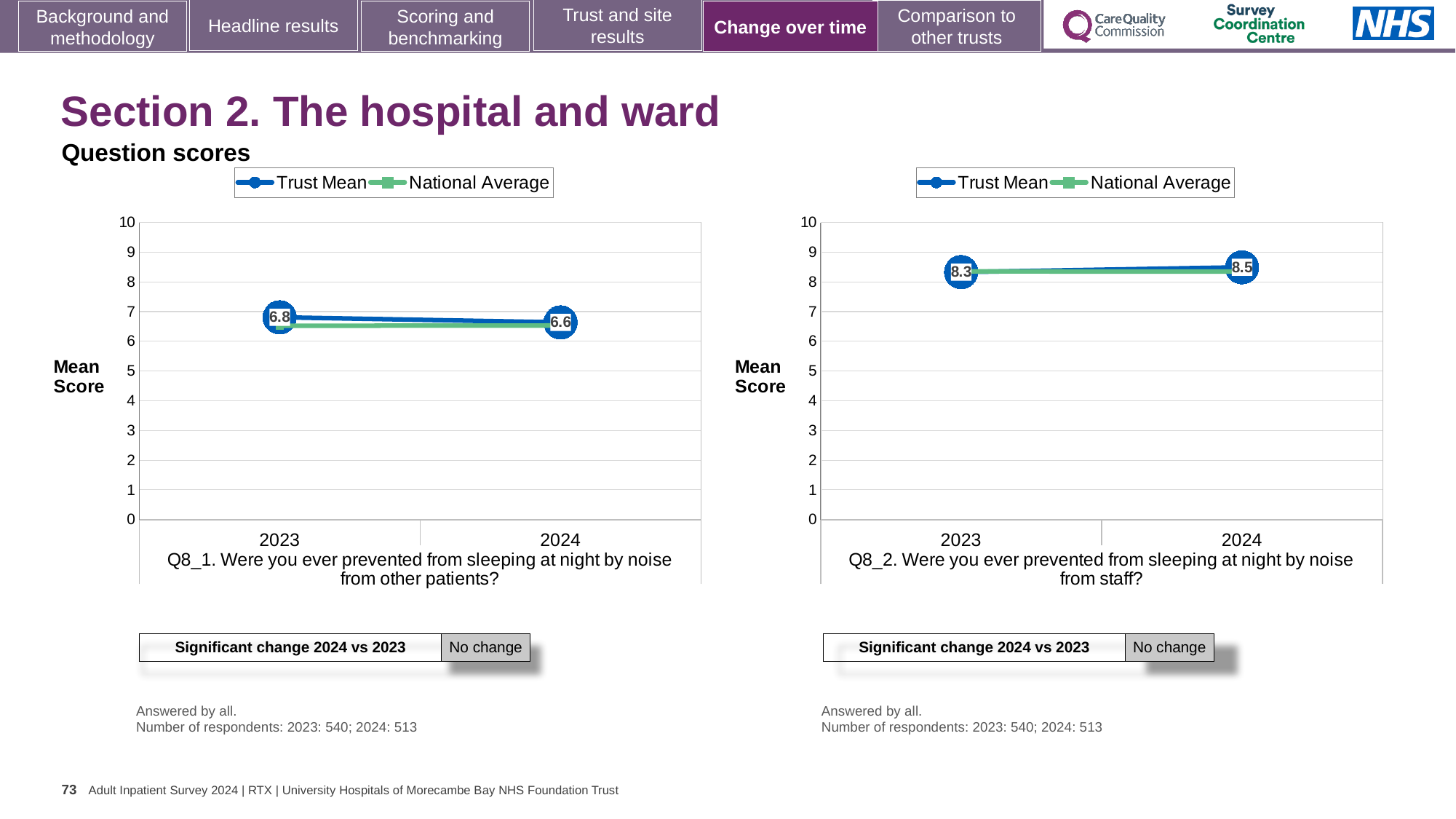
In the right chart (Q8_2, noise from staff), what is the Trust Mean score for 2024? 8.5 In the left chart (Q8_1), by how much did the Trust Mean change from 2023 to 2024? 0.2 In the left chart (Q8_1), does the Trust Mean rise or fall from 2023 to 2024? fall In the right chart (Q8_2), is the National Average for 2023 greater or less than 7? greater In the right chart (Q8_2), does the Trust Mean rise or fall from 2023 to 2024? rise How many series does the legend of the right chart (Q8_2) list? 2 What kind of chart is used on the left for Q8_1? line chart In the left chart (Q8_1, noise from other patients), what is the Trust Mean score for 2023? 6.8 Which is larger: the 2024 Trust Mean in the left chart (Q8_1) or the 2024 Trust Mean in the right chart (Q8_2)? Q8_2 (right chart) In the right chart (Q8_2, noise from staff), what is the Trust Mean score for 2023? 8.3 In the right chart (Q8_2), what is the difference between the Trust Mean for 2024 and 2023? 0.2 In the left chart (Q8_1, noise from other patients), what is the Trust Mean score for 2024? 6.6